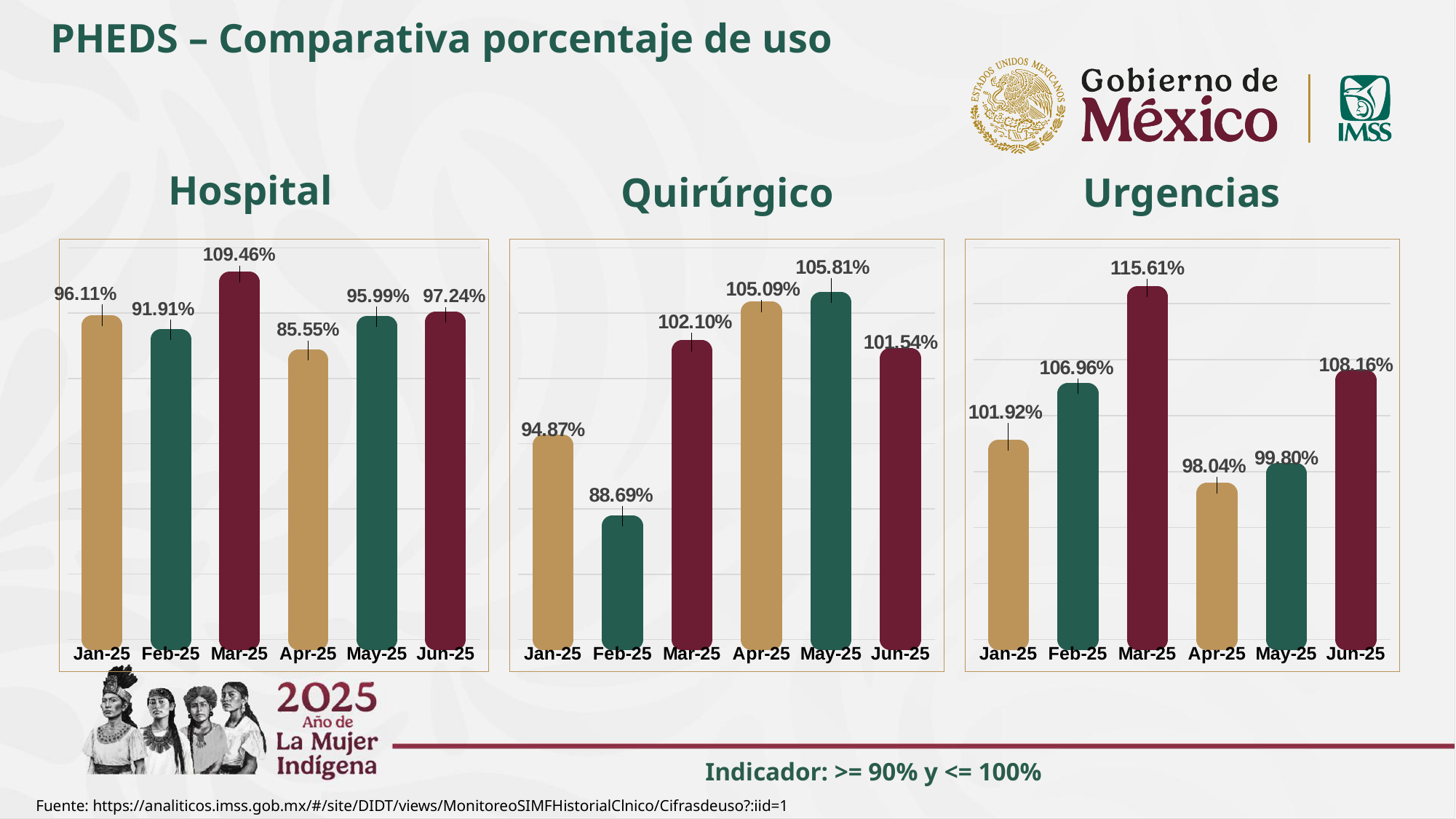
What kind of chart is the Urgencias chart? Bar chart In the Urgencias chart, which month has the highest value? Mar-25 In the Hospital chart, what is the difference between the Mar-25 and Apr-25 values? 23.91% What is the title of the slide? PHEDS – Comparativa porcentaje de uso In the Urgencias chart, what is the difference between the Mar-25 and Apr-25 values? 17.57% In the Urgencias chart, what is the value for Jun-25? 108.16% In the Hospital chart, what is the value for Mar-25? 109.46% In the Quirúrgico chart, which month has the highest value? May-25 In the Quirúrgico chart, what is the value for Feb-25? 88.69% How many months are shown in the Hospital chart? 6 In the Hospital chart, which month has the lowest value? Apr-25 In the Quirúrgico chart, which is larger, the value for Jan-25 or the value for Jun-25? Jun-25